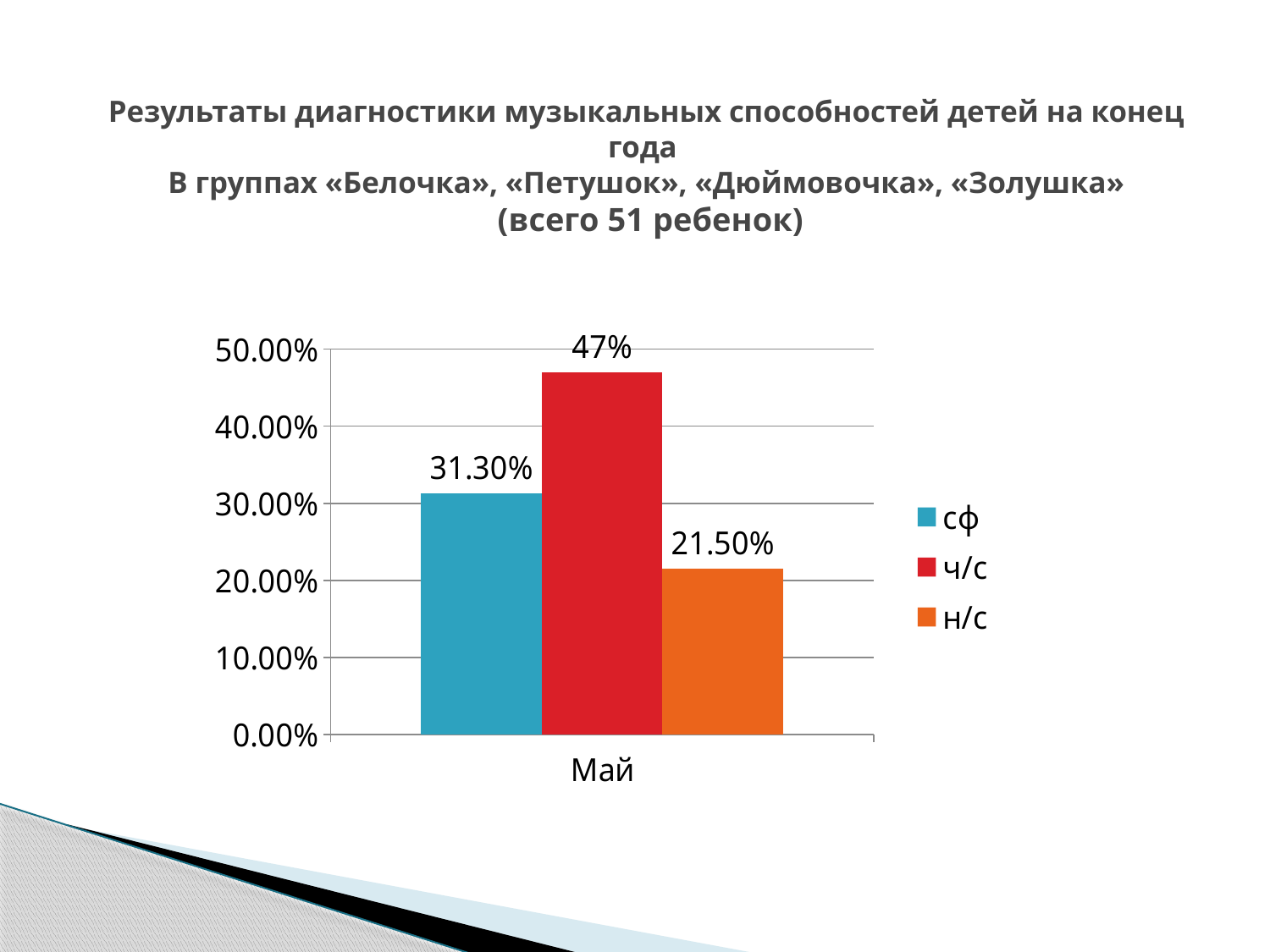
What is the difference between the сф value and the н/с value in Май? 9.80% How many series does the legend list? 3 Which series has the highest value in Май? ч/с Which is larger in Май, the сф value or the ч/с value? ч/с What is the difference between the ч/с value and the н/с value in Май? 25.50% Is the value for сф in Май greater or less than 30.00%? greater What kind of chart is shown on the slide? bar chart What is the value for the н/с series in Май? 21.50% Which series has the lowest value in Май? н/с What is the value for the сф series in Май? 31.30% What is the category label on the x axis? Май What is the value for the ч/с series in Май? 47%